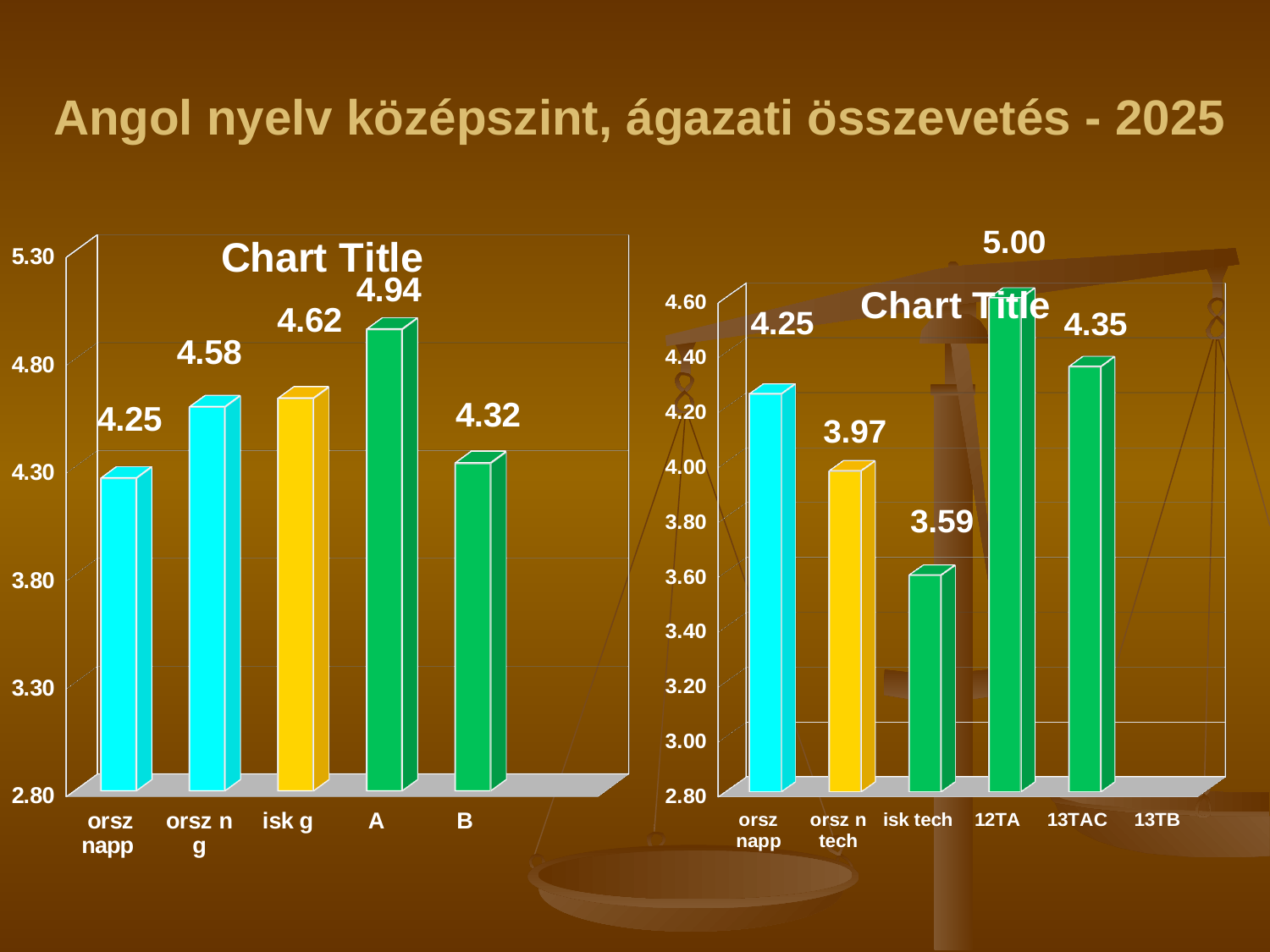
In the left chart, what is the difference between the values for A and B? 0.62 In the left chart, which is larger, the value for orsz n g or the value for B? orsz n g In the right chart, what is the value for isk tech? 3.59 In the left chart, how many categories are shown on the x axis? 5 In the right chart, what is the difference between the values for 12TA and 13TAC? 0.65 In the right chart, which category has the highest value? 12TA In the right chart, is the value for orsz n tech greater or less than 4.00? less In the left chart, which category has the highest value? A In the left chart, which category has the lowest value? orsz napp In the left chart, what is the value for isk g? 4.62 What kind of chart is the left chart? bar chart